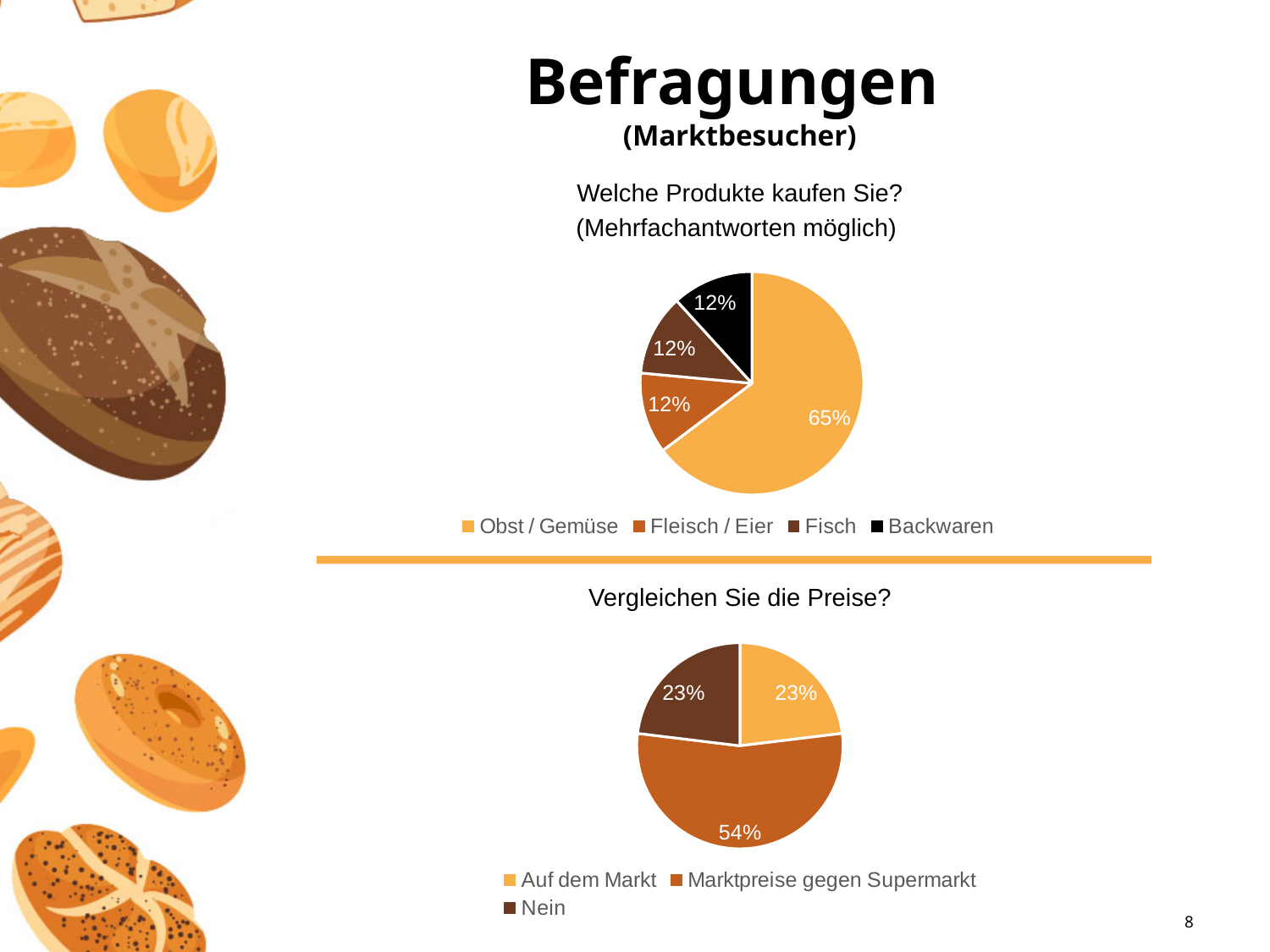
In the chart titled "Vergleichen Sie die Preise?", what share is shown for Marktpreise gegen Supermarkt? 54% In the chart titled "Vergleichen Sie die Preise?", how many categories does the legend list? 3 In the chart titled "Welche Produkte kaufen Sie?", how many categories does the legend list? 4 What kind of chart is used for "Vergleichen Sie die Preise?"? Pie chart In the chart titled "Welche Produkte kaufen Sie?", what is the difference between the shares for Obst / Gemüse and Fisch? 53 percentage points In the chart titled "Welche Produkte kaufen Sie?", what share is shown for Backwaren? 12% In the chart titled "Vergleichen Sie die Preise?", which category has the largest share? Marktpreise gegen Supermarkt In the chart titled "Welche Produkte kaufen Sie?", which category is shown in black? Backwaren In the chart titled "Welche Produkte kaufen Sie?", what share of respondents buy Obst / Gemüse? 65% In the chart titled "Vergleichen Sie die Preise?", what share is shown for Nein? 23% In the chart titled "Welche Produkte kaufen Sie?", which is larger, the share for Obst / Gemüse or the share for Fleisch / Eier? Obst / Gemüse In the chart titled "Welche Produkte kaufen Sie?", which category has the largest share? Obst / Gemüse